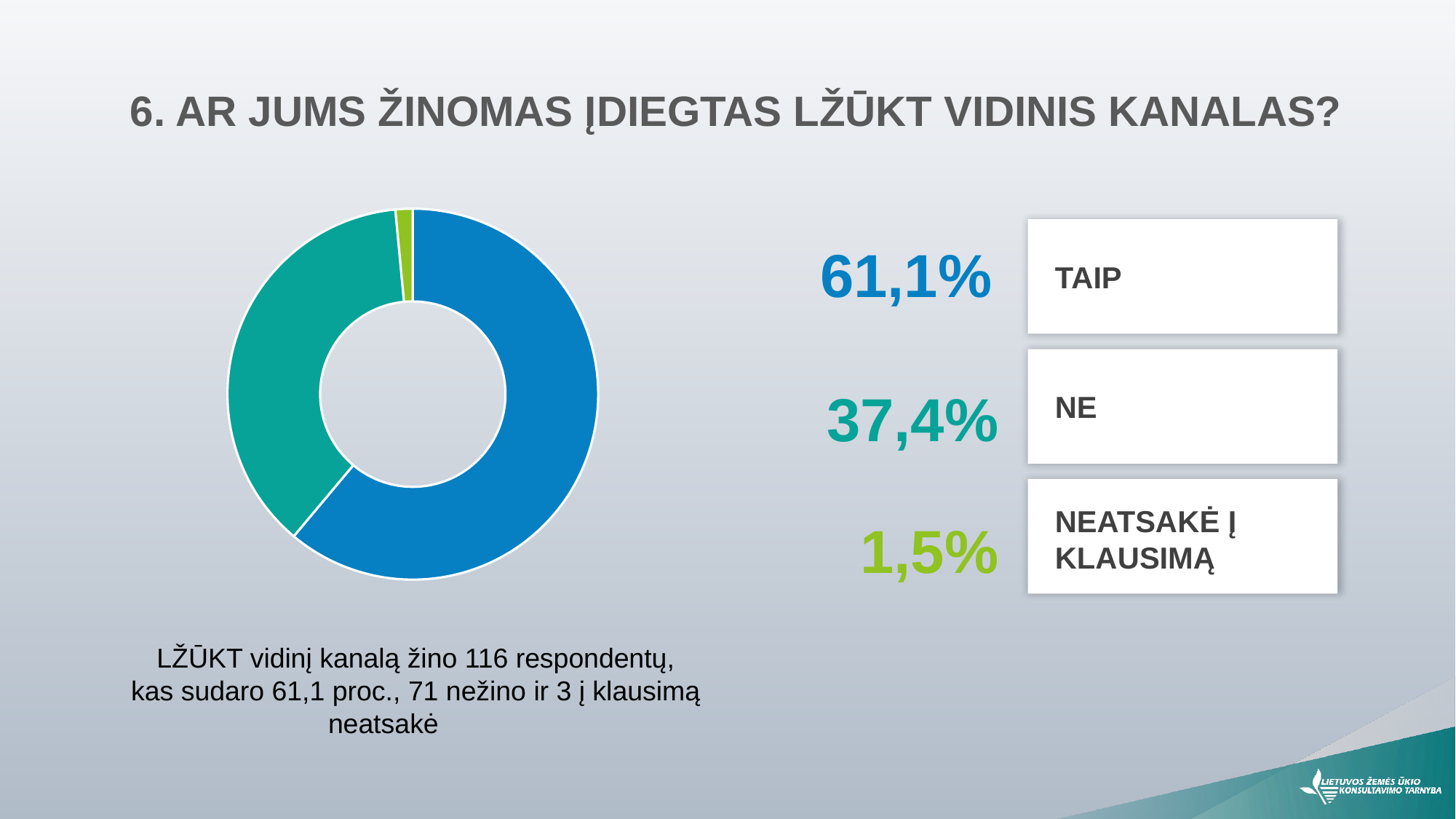
Which is larger, the share for TAIP or the share for NE? TAIP What is the difference in percentage points between the TAIP and NE shares? 23,7 What kind of chart is shown on the slide? Donut (pie) chart What colour is the slice representing TAIP? Blue According to the text below the chart, how many respondents know the LŽŪKT internal channel? 116 What colour is the slice representing NEATSAKĖ Į KLAUSIMĄ? Green What share of respondents answered TAIP? 61,1% What share of respondents answered NE? 37,4% Which answer category has the largest share of the chart? TAIP Which answer category has the smallest share of the chart? NEATSAKĖ Į KLAUSIMĄ What share of respondents did not answer the question (NEATSAKĖ Į KLAUSIMĄ)? 1,5% How many categories does the chart show? 3